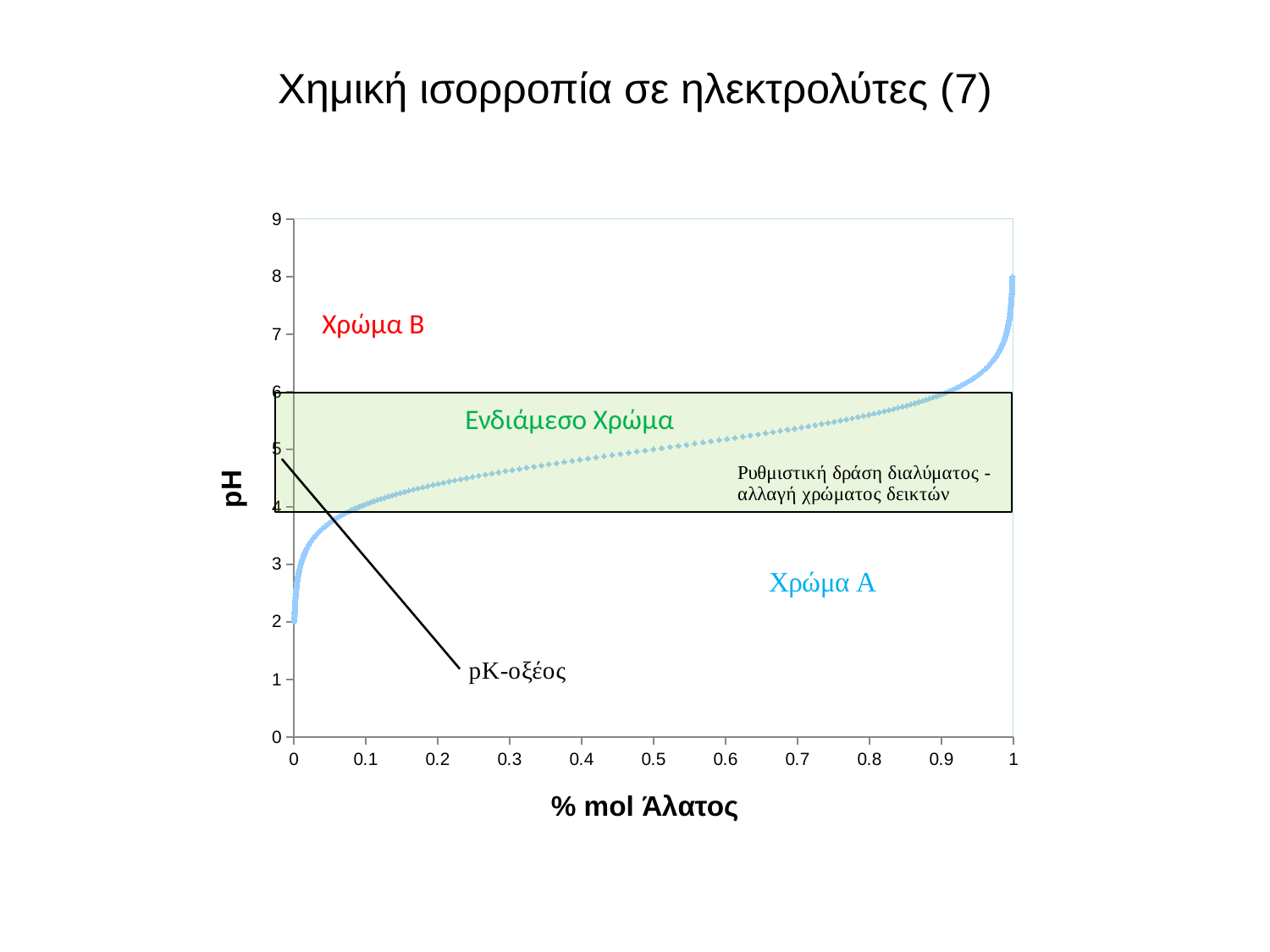
Is the pH value at 0.9 % mol Άλατος greater or less than 5? greater What kind of chart is shown on the slide? line chart Which has the higher pH on the curve: 0.3 % mol Άλατος or 0.7 % mol Άλατος? 0.7 Is the pH value at 0.1 % mol Άλατος greater or less than 5? less Between which two pH values does the shaded region labelled 'Ενδιάμεσο Χρώμα' lie? 4 and 6 What is the highest value shown on the pH axis? 9 What is the label of the horizontal axis? % mol Άλατος Does the pH curve rise or fall as % mol Άλατος increases from 0 to 1? rise Is the pH value at 0.2 % mol Άλατος greater or less than 6? less